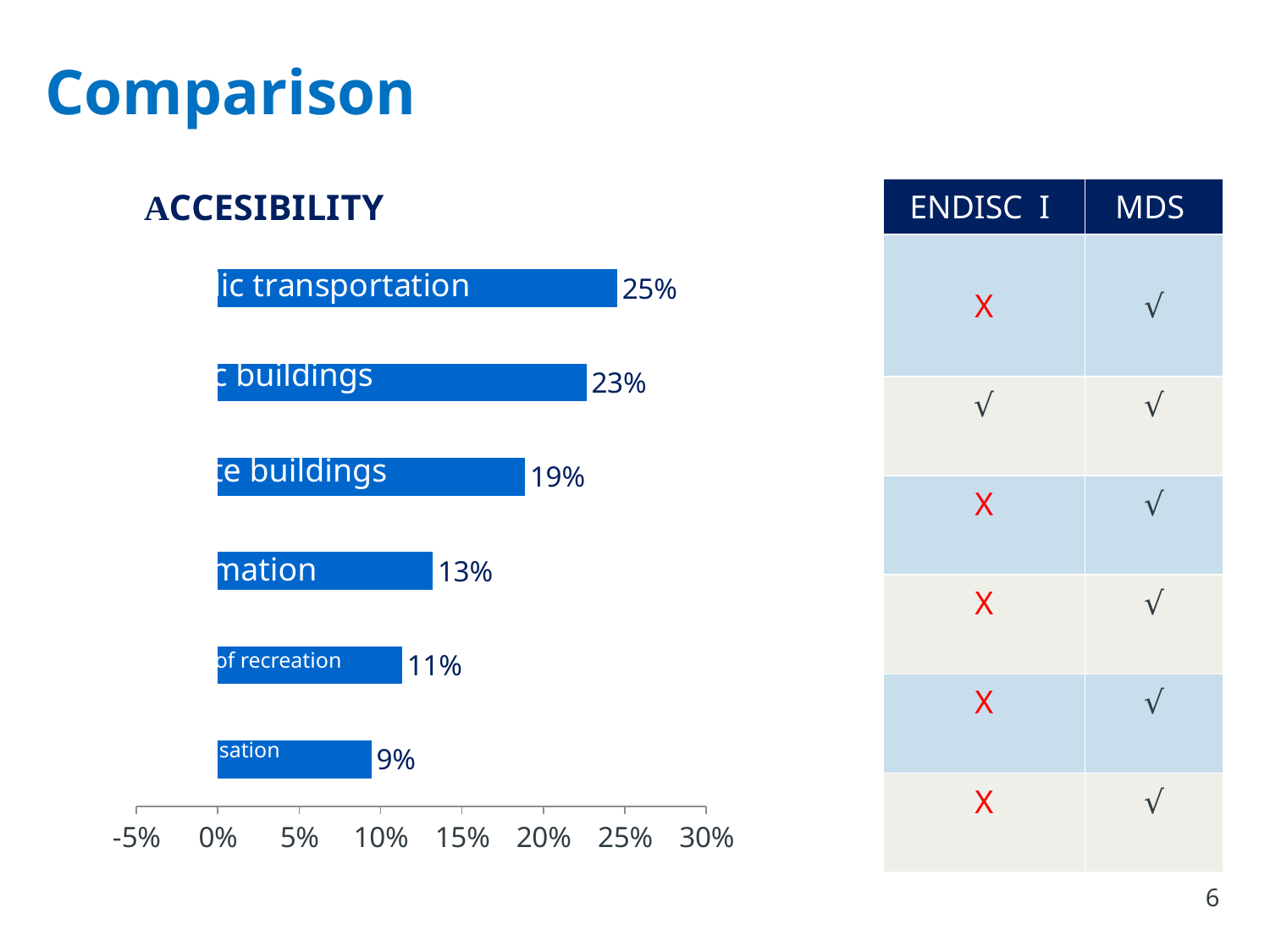
What is the value of the top bar in the ACCESIBILITY chart (the one whose label ends in 'transportation')? 25% What is the value of the bottom bar in the ACCESIBILITY chart? 9% Which bar has the highest value in the ACCESIBILITY chart? the top bar (label ending in 'transportation'), 25% In the ACCESIBILITY chart, what is the difference between the top bar (25%) and the bottom bar (9%)? 16% What is the value of the fourth bar from the top (label ending in 'mation') in the ACCESIBILITY chart? 13% What is the value of the bar whose label ends in 'of recreation' in the ACCESIBILITY chart? 11% What type of chart is shown under the heading ACCESIBILITY? bar chart What is the lowest value shown in the ACCESIBILITY chart? 9% How many bars does the ACCESIBILITY chart contain? 6 What is the highest tick value shown on the horizontal axis of the ACCESIBILITY chart? 30% In the ACCESIBILITY chart, which is larger: the second bar from the top (label ending in 'buildings') or the third bar from the top? the second bar from the top, 23% Do the bar values in the ACCESIBILITY chart increase or decrease from top to bottom? decrease